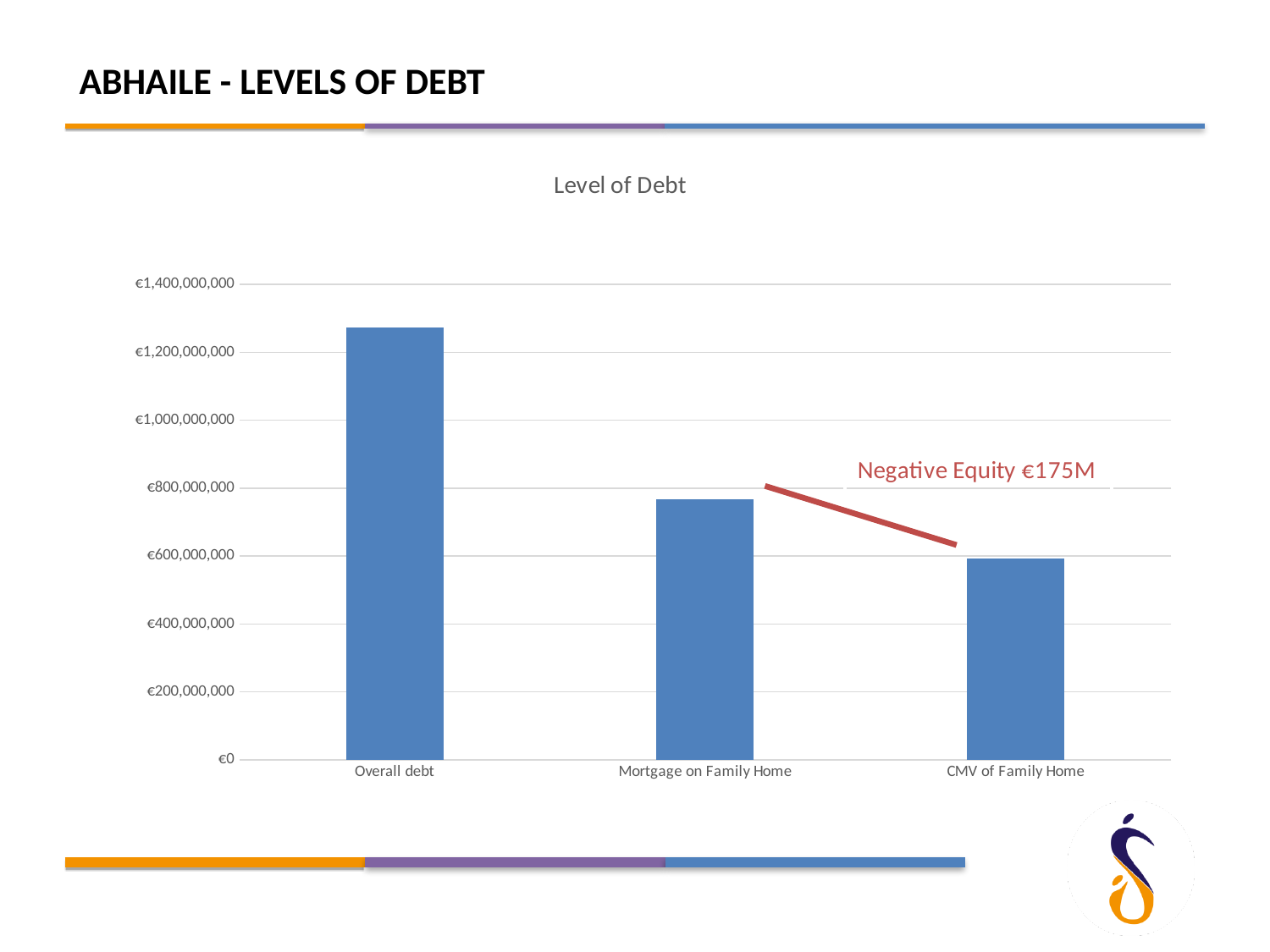
Which category has the highest value? Overall debt Which is larger, Mortgage on Family Home or CMV of Family Home? Mortgage on Family Home Which category has the lowest value? CMV of Family Home What amount of negative equity does the annotation on the chart state? €175M What is the title of the chart? Level of Debt Do the bar values rise or fall from left to right across the categories? fall Is the value for Overall debt greater or less than €1,200,000,000? greater Is the value for Overall debt greater or less than €1,400,000,000? less Is the value for Mortgage on Family Home greater or less than €800,000,000? less How many categories are plotted in the chart? 3 What kind of chart is shown on the slide? bar chart